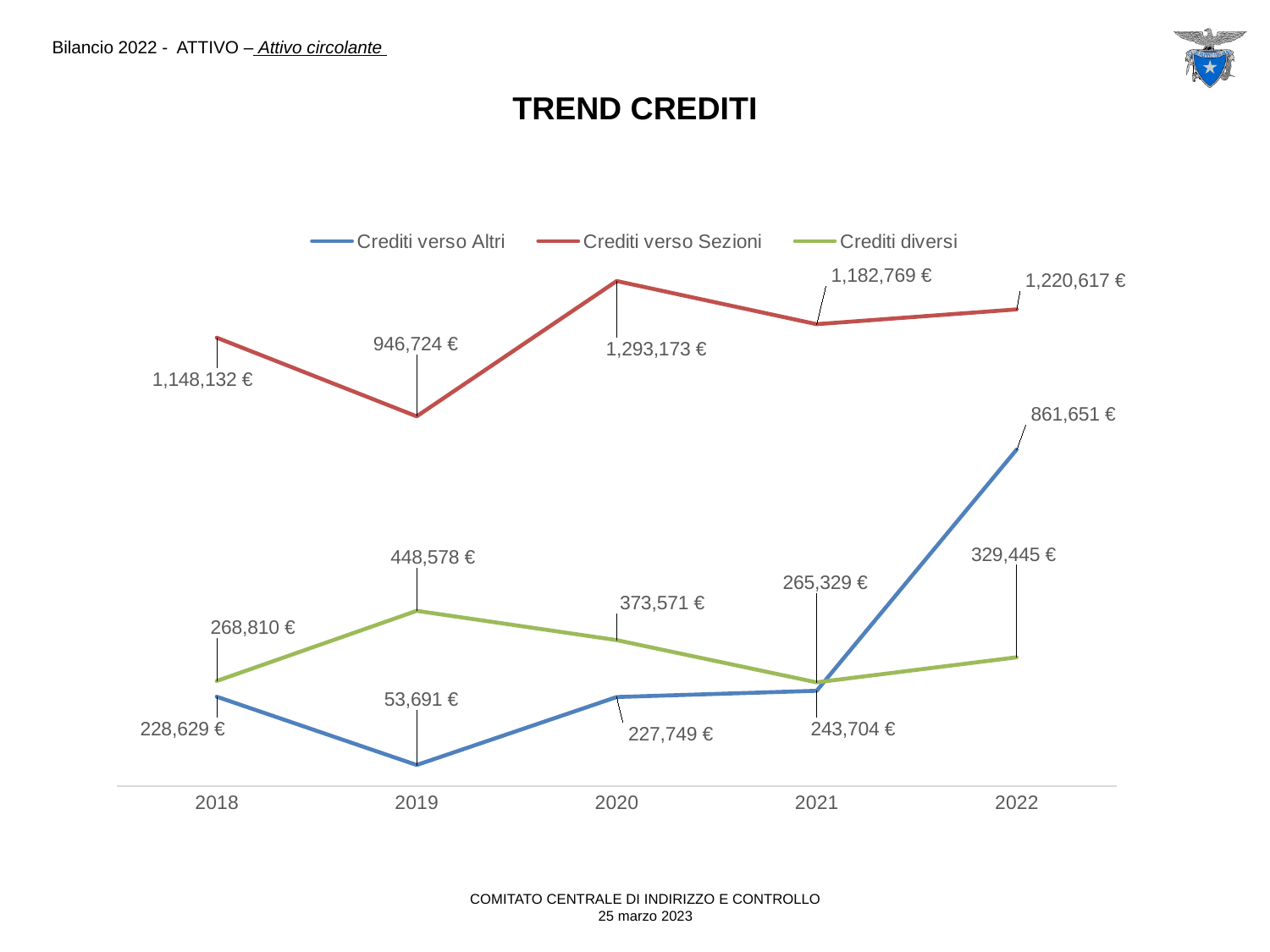
What is the value of Crediti diversi in 2022? 329,445 € What is the title of the chart? TREND CREDITI What is the difference between Crediti verso Altri in 2022 and in 2021? 617,947 € What type of chart is shown on the slide? line chart Which is larger in 2019: Crediti diversi or Crediti verso Altri? Crediti diversi How many years are shown on the x axis? 5 Does Crediti verso Sezioni rise or fall from 2018 to 2019? fall In which year is Crediti verso Sezioni at its lowest? 2019 What is the value of Crediti verso Sezioni in 2020? 1,293,173 € How many series does the legend list? 3 What is the value of Crediti verso Altri in 2019? 53,691 € In which year is Crediti verso Altri at its highest? 2022